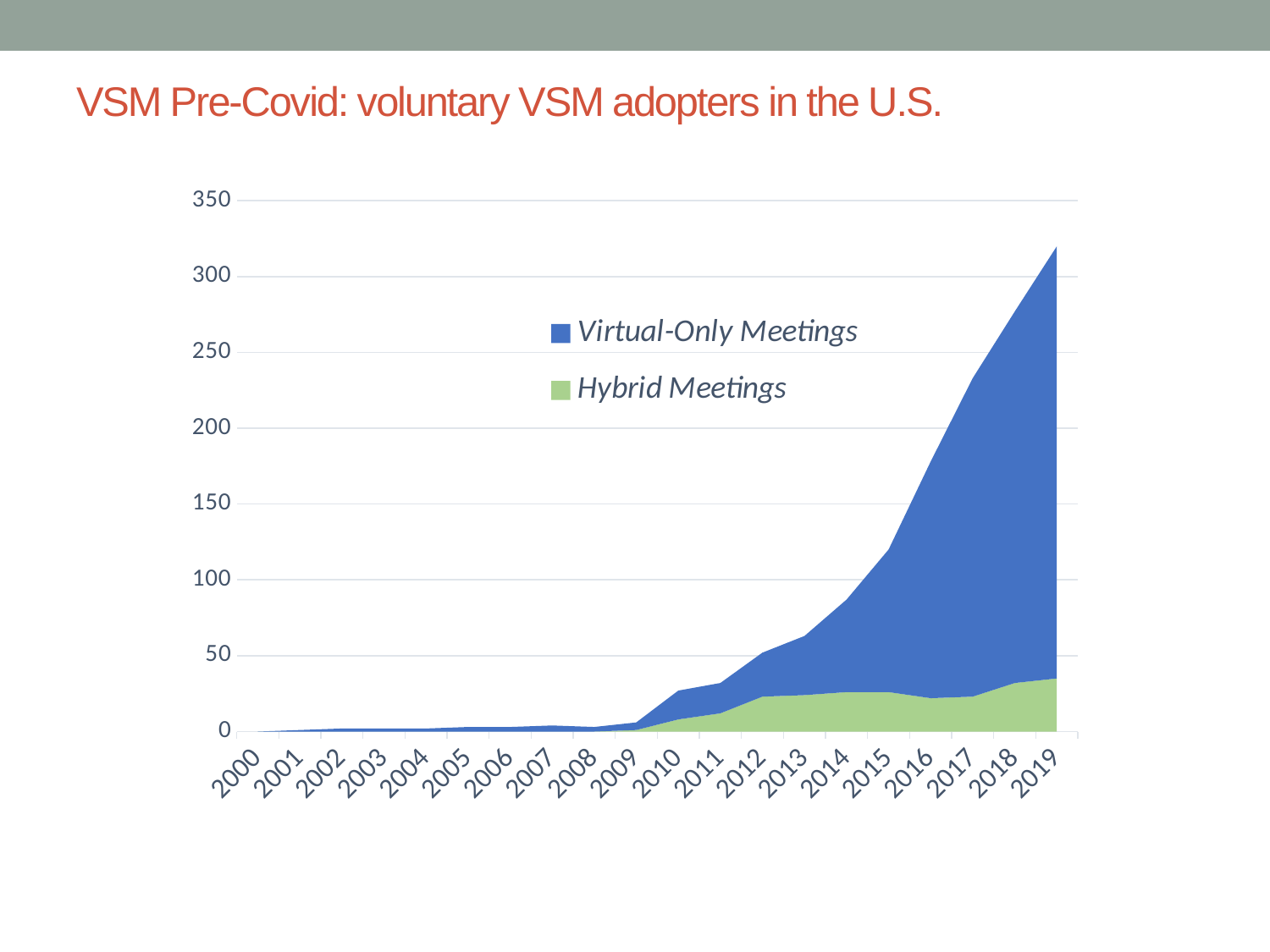
Is the total value for 2019 greater or less than 300? greater How many years are shown along the x axis? 20 Which year has the highest total number of VSM adopters? 2019 Is the total value for 2010 greater or less than 50? less What kind of chart is shown on the slide? Area chart How many series does the legend list? 2 Do the total values generally rise or fall from 2000 to 2019? Rise Which year has the lowest total number of VSM adopters? 2000 Is the value for Hybrid Meetings in 2019 greater or less than 50? less What are the two series named in the legend? Virtual-Only Meetings and Hybrid Meetings Which series is larger in 2019, Virtual-Only Meetings or Hybrid Meetings? Virtual-Only Meetings